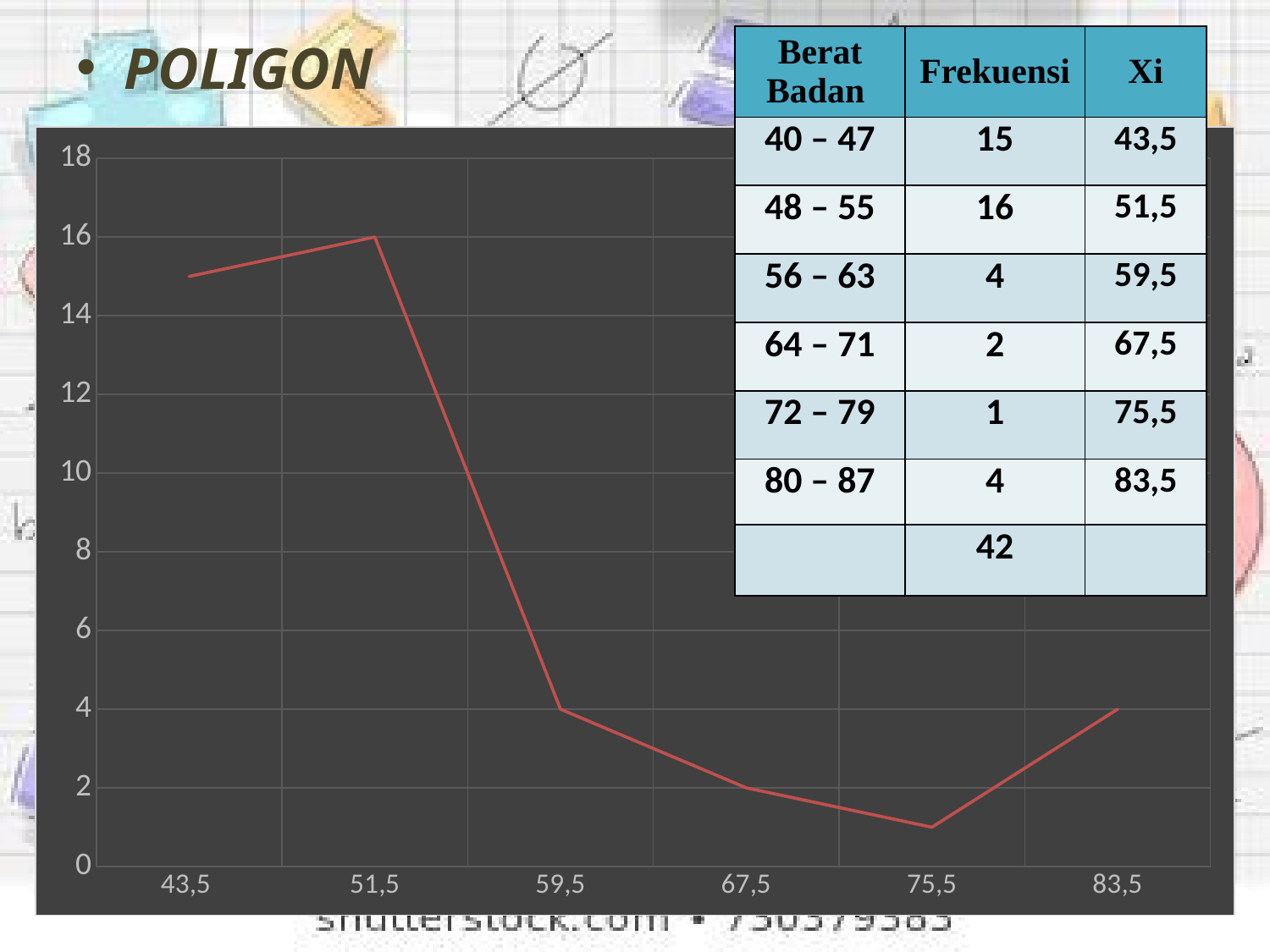
How many points are plotted on the line? 6 What is the frequency value plotted at 75,5? 1 Does the line rise or fall between 75,5 and 83,5? rise What is the frequency value plotted at 43,5? 15 What kind of chart is shown on the slide? line chart At which x-axis value does the line reach its highest point? 51,5 At which x-axis value does the line reach its lowest point? 75,5 What is the difference between the values at 51,5 and 59,5? 12 What is the frequency value plotted at 59,5? 4 What is the frequency value plotted at 51,5? 16 Which is larger, the value at 43,5 or the value at 83,5? 43,5 Is the value at 67,5 greater or less than 4? less